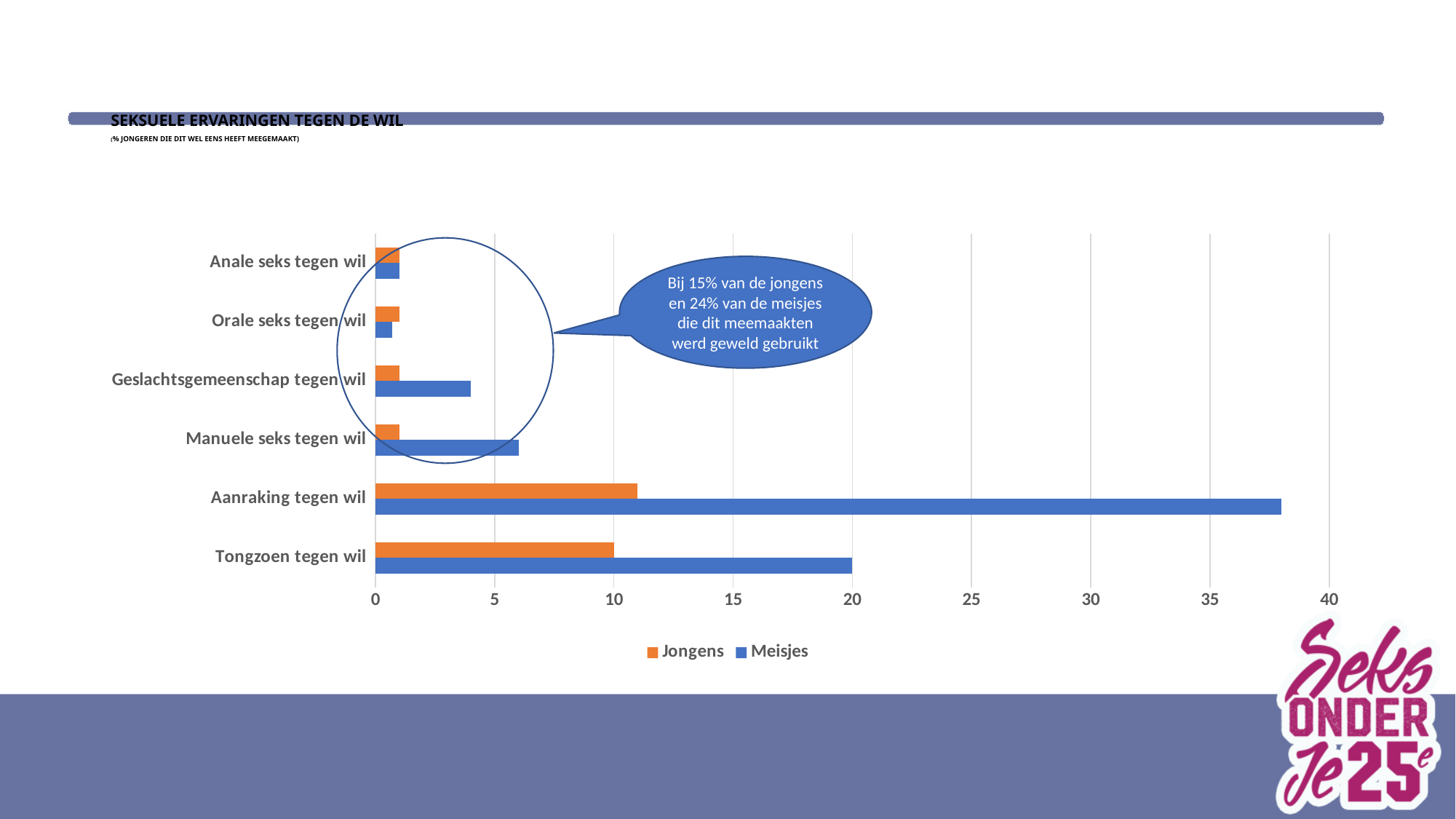
For Geslachtsgemeenschap tegen wil, which series has the larger value, Jongens or Meisjes? Meisjes How many categories are plotted on the chart? 6 Is the value for Meisjes in Aanraking tegen wil greater or less than 35? greater Is the value for Meisjes in Manuele seks tegen wil greater or less than 5? greater Which category has the highest value for Jongens? Aanraking tegen wil Which category has the highest value for Meisjes? Aanraking tegen wil What are the two series names listed in the legend? Jongens, Meisjes What is the value for Meisjes in Tongzoen tegen wil? 20 For Tongzoen tegen wil, which series has the larger value, Jongens or Meisjes? Meisjes Is the value for Jongens in Aanraking tegen wil greater or less than 15? less What kind of chart is shown on the slide? bar chart How many series does the legend list? 2